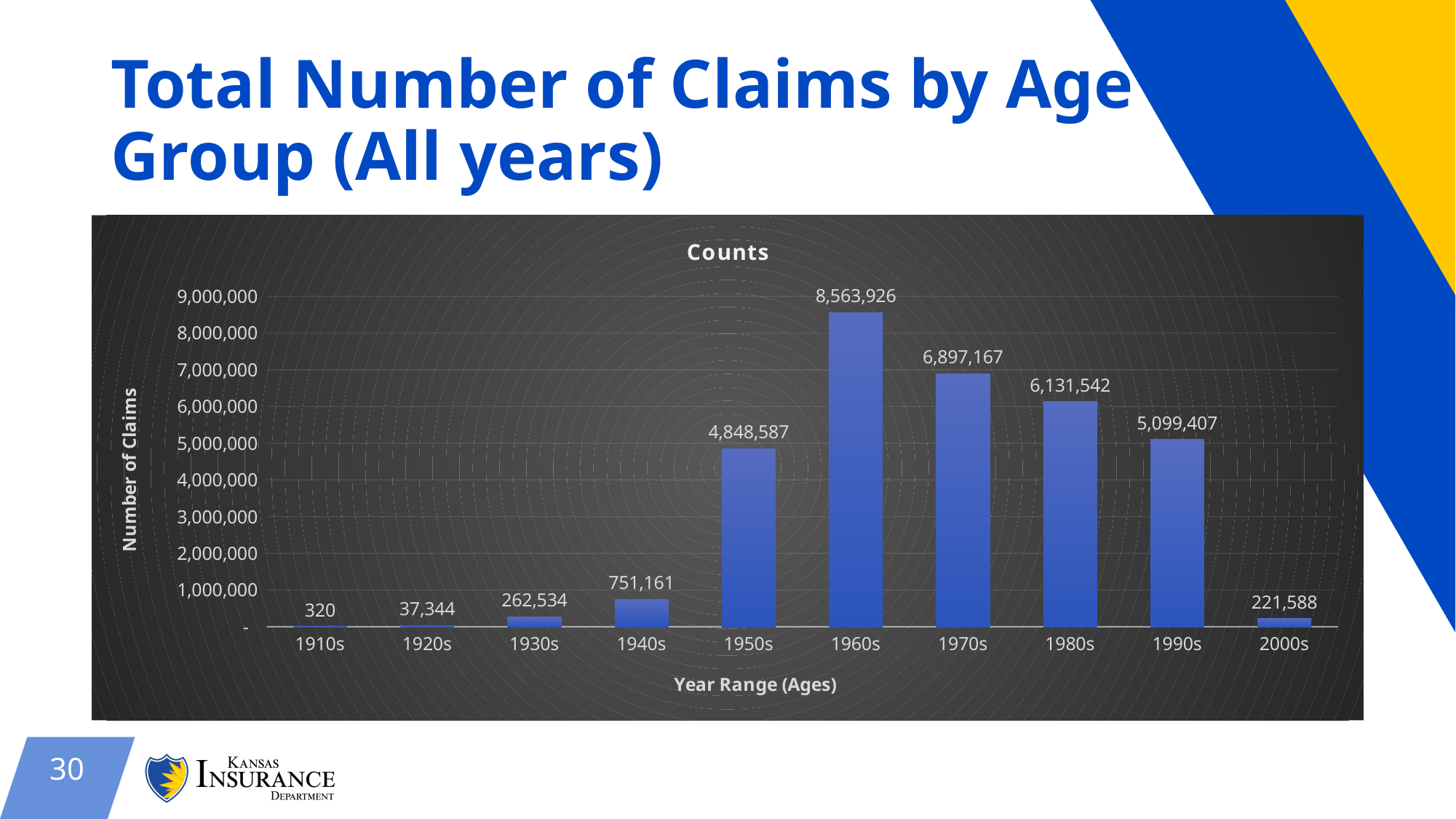
What is the difference in number of claims between the 1960s and 1970s age groups? 1,666,759 What is the number of claims for the 1960s age group? 8,563,926 Which age group has the lowest number of claims? 1910s Which age group has more claims, the 1950s or the 1980s? 1980s What is the number of claims for the 2000s age group? 221,588 How many age groups are shown on the x axis? 10 What kind of chart is shown on the slide? Bar chart What is the title shown above the chart? Counts What is the difference in number of claims between the 1980s and 1990s age groups? 1,032,135 Which age group has the highest number of claims? 1960s What is the number of claims for the 1990s age group? 5,099,407 What is the number of claims for the 1910s age group? 320